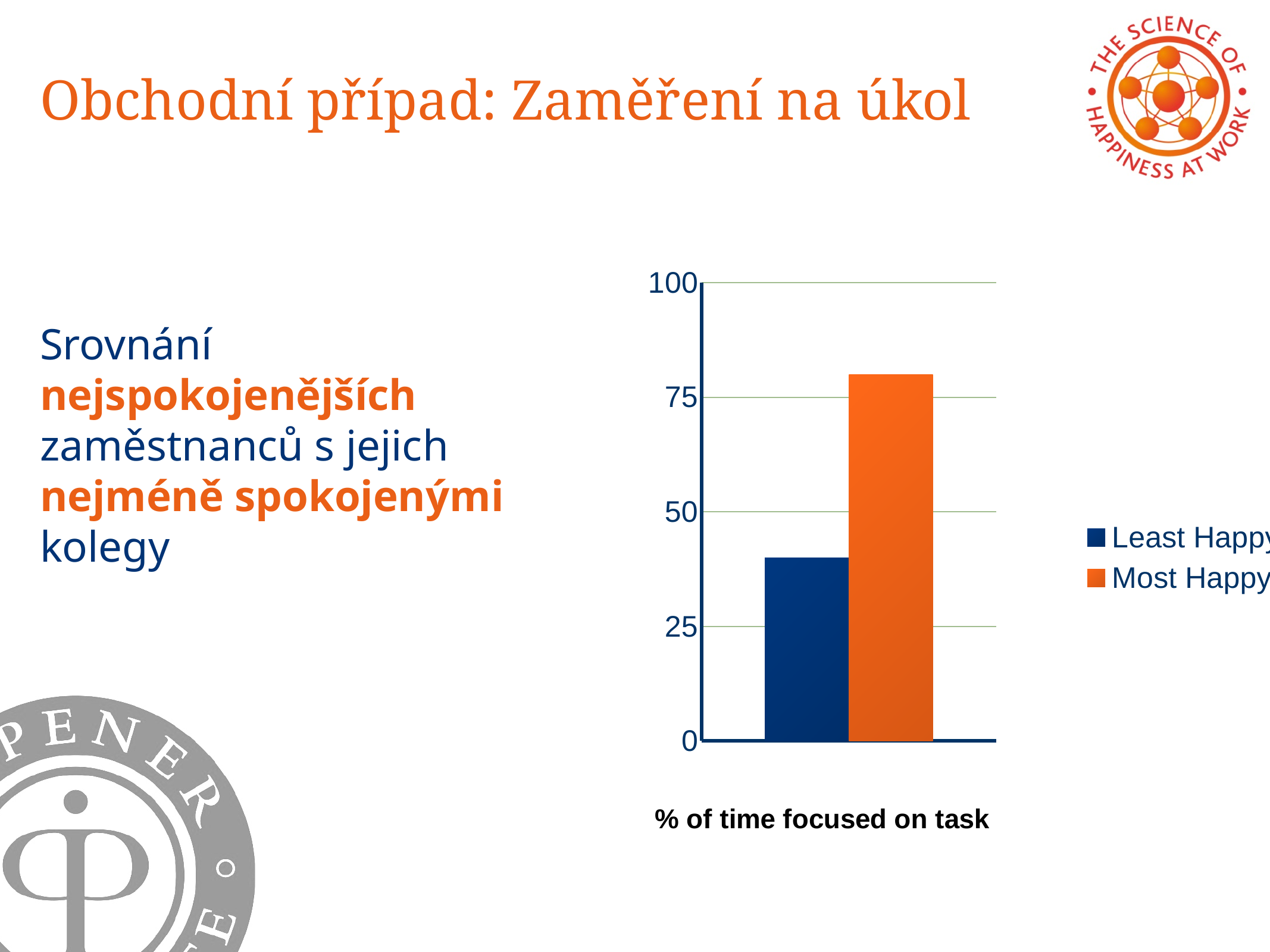
Which series has the taller bar, Least Happy or Most Happy? Most Happy Is the value for Least Happy greater or less than 25? greater How many bars are plotted in the chart? 2 Which series has the lowest value in the chart? Least Happy What colour is the bar for the Most Happy series? orange What label appears below the chart's horizontal axis? % of time focused on task Which series has the highest value in the chart? Most Happy Is the value for Most Happy greater or less than 100? less Is the value for Least Happy greater or less than 50? less How many series does the chart's legend list? 2 What kind of chart is shown on the slide? bar chart